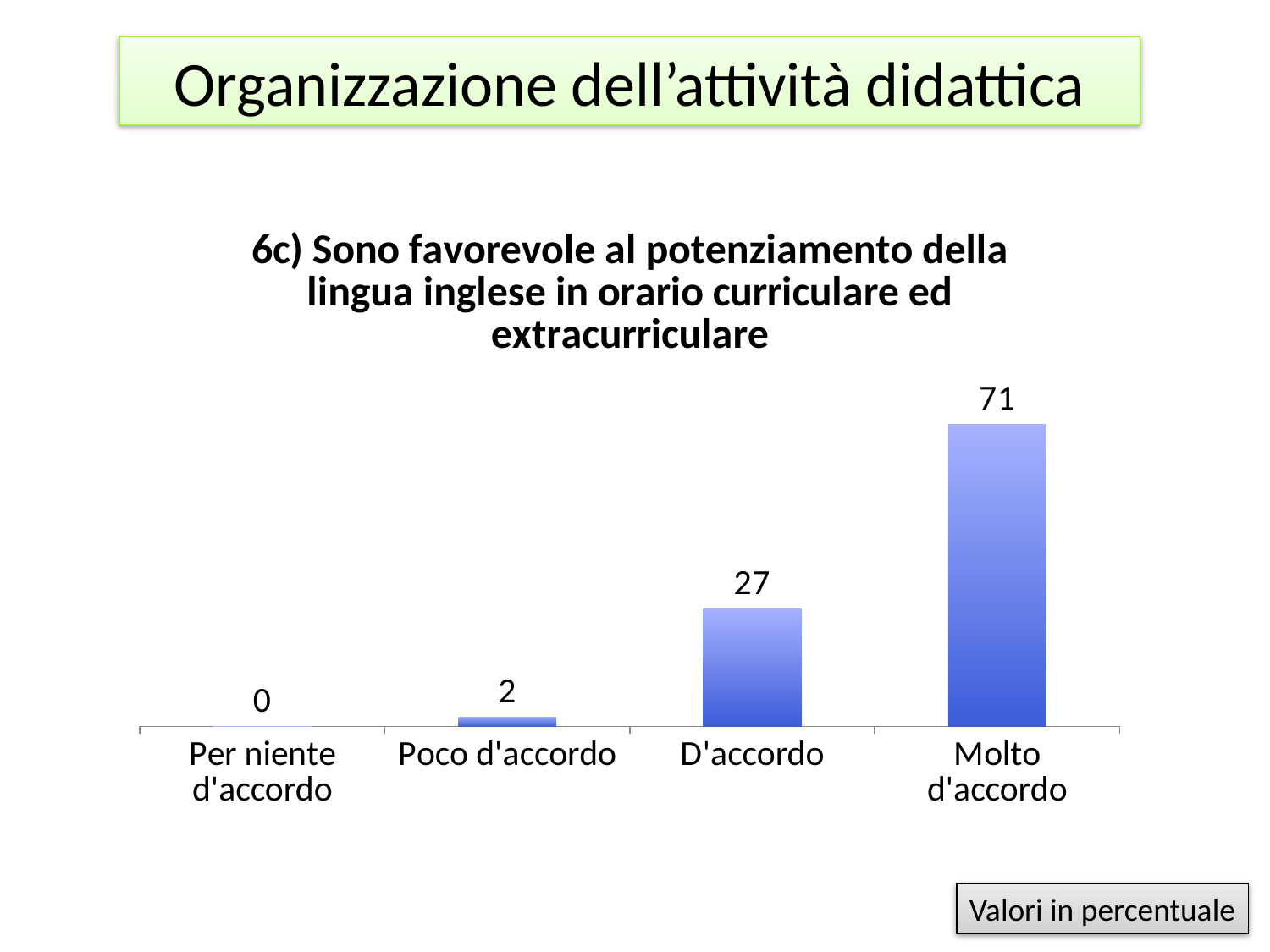
What is the value for "Molto d'accordo"? 71 What is the value for "D'accordo"? 27 What is the title of the chart? 6c) Sono favorevole al potenziamento della lingua inglese in orario curriculare ed extracurriculare Do the values rise or fall from left to right along the x axis? Rise What is the value for "Poco d'accordo"? 2 What is the value for "Per niente d'accordo"? 0 Which is larger, the value for "D'accordo" or the value for "Poco d'accordo"? D'accordo Which category has the highest value? Molto d'accordo Which category has the lowest value? Per niente d'accordo What kind of chart is shown on the slide? Bar chart What is the difference between the values for "Molto d'accordo" and "D'accordo"? 44 How many categories are shown on the x axis? 4